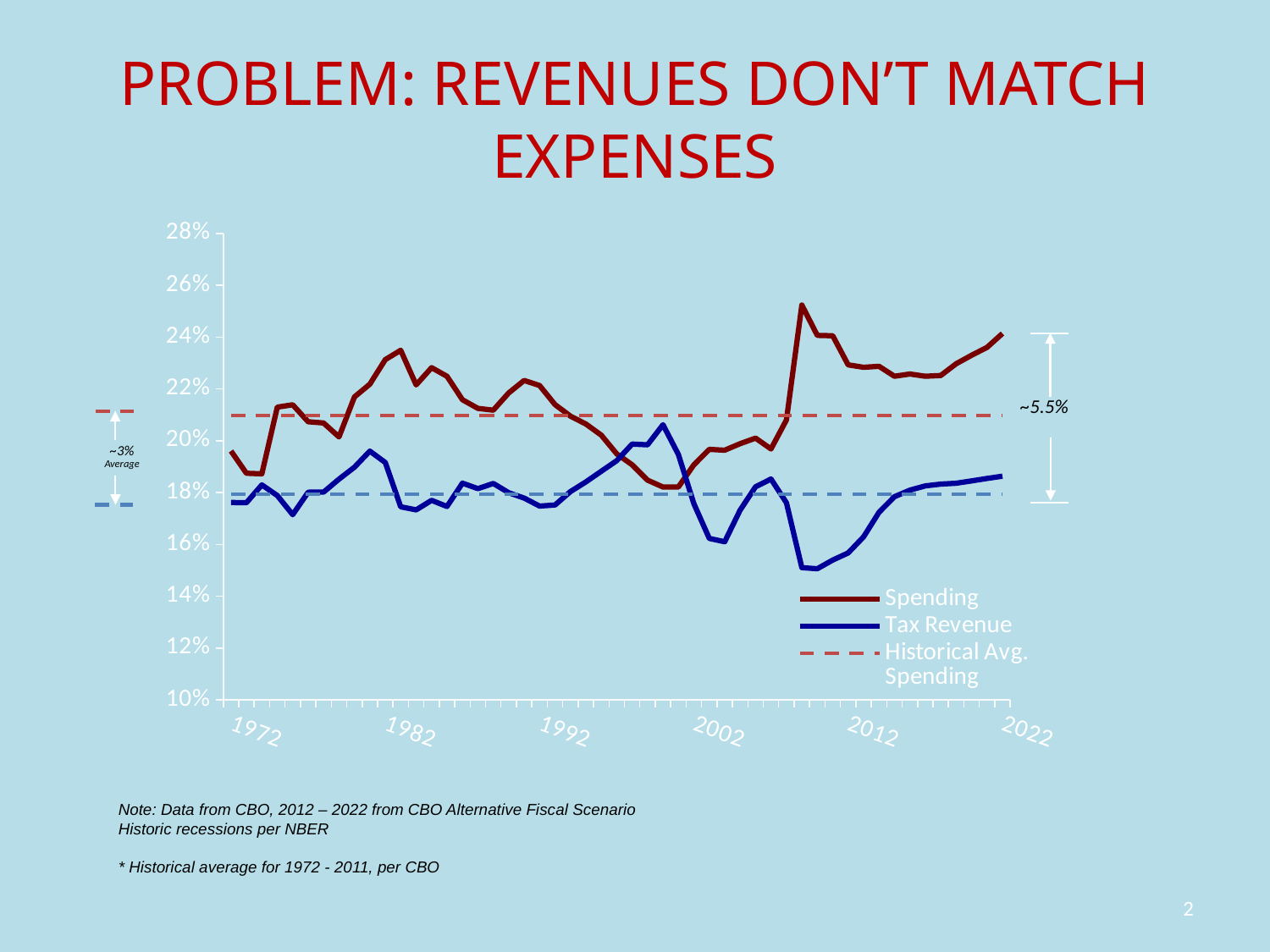
Which series reaches the highest value on the chart? Spending Is the highest value reached by Spending greater or less than 24%? greater How many series does the chart's legend list? 3 What is the title of the slide containing the chart? PROBLEM: REVENUES DON'T MATCH EXPENSES Is the value for Tax Revenue in 2022 greater or less than 20%? less In 2022, which is larger, Spending or Tax Revenue? Spending How many year labels are shown on the x axis? 6 Is the lowest value reached by Tax Revenue greater or less than 16%? less Does Tax Revenue rise or fall between 2012 and 2022? rise Which series does the legend show with a dashed line? Historical Avg. Spending What kind of chart is shown on the slide? line chart